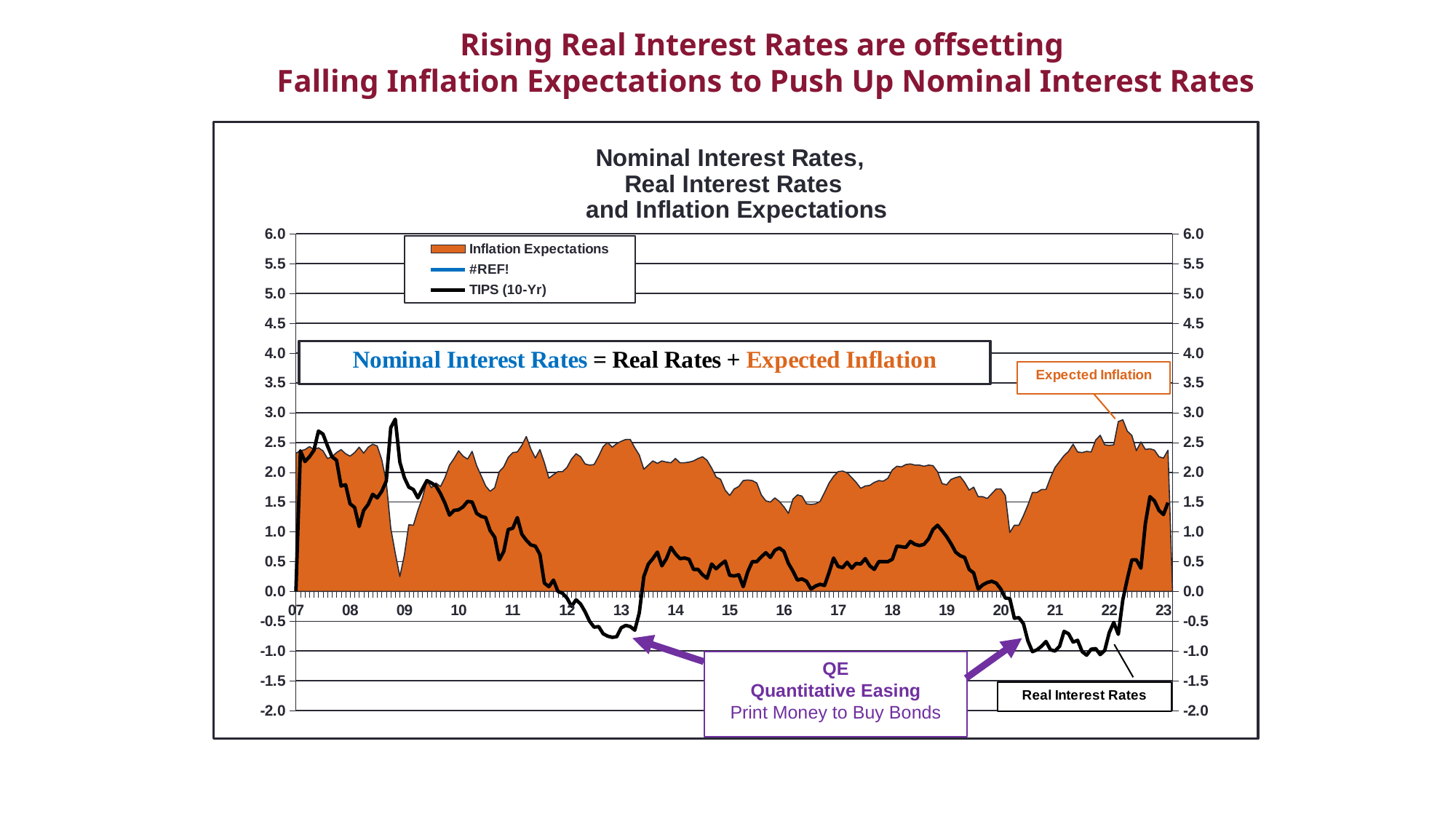
Does the Inflation Expectations series rise or fall between 2020 and 2022? rise Is the TIPS (10-Yr) value in 2021 greater or less than 0.0? less Is the TIPS (10-Yr) value at the start of 2023 greater or less than 1.0? greater What is the title of the chart? Nominal Interest Rates, Real Interest Rates and Inflation Expectations Does the TIPS (10-Yr) line rise or fall between 2021 and 2023? rise Which series is shown as the orange shaded area? Inflation Expectations Is the peak Inflation Expectations value in 2022 greater or less than 2.5? greater How many series does the chart's legend list? 3 What kind of chart is shown on the slide? A combined area and line chart How many year labels are shown on the x axis? 17